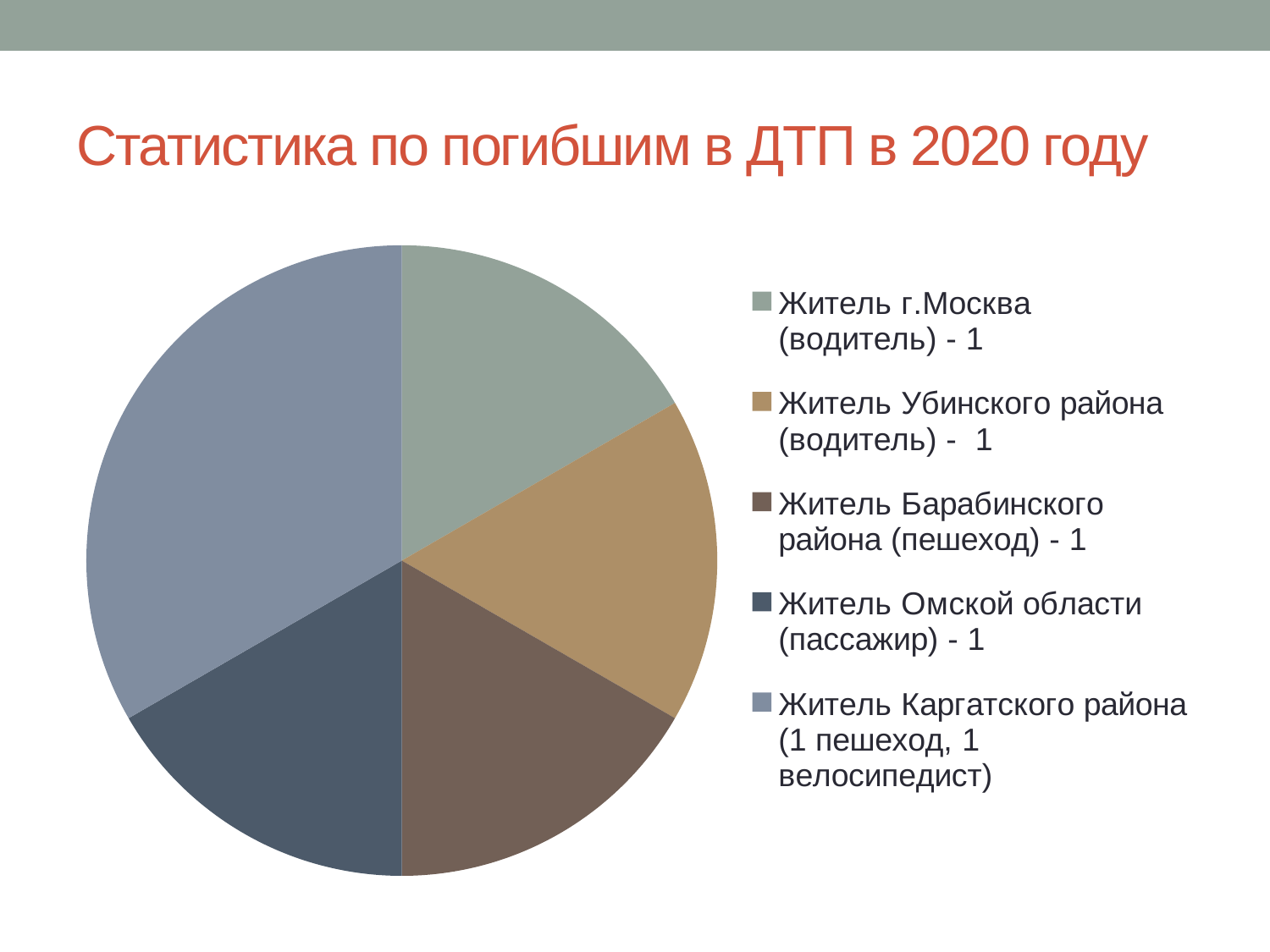
What colour is the slice for Житель Убинского района (водитель)? tan/brown According to the legend, how is the Житель Каргатского района entry broken down? 1 пешеход, 1 велосипедист What is the title of the chart on the slide? Статистика по погибшим в ДТП в 2020 году How many slices does the pie chart have? 5 What value is given for Житель Омской области (пассажир)? 1 What value is given for Житель Барабинского района (пешеход)? 1 How many entries does the legend list? 5 What value is given for Житель г.Москва (водитель)? 1 Which slice is larger: Житель Каргатского района or Житель г.Москва (водитель)? Житель Каргатского района What kind of chart is shown on the slide? pie chart Which category has the largest slice of the pie? Житель Каргатского района What value is given for Житель Убинского района (водитель)? 1